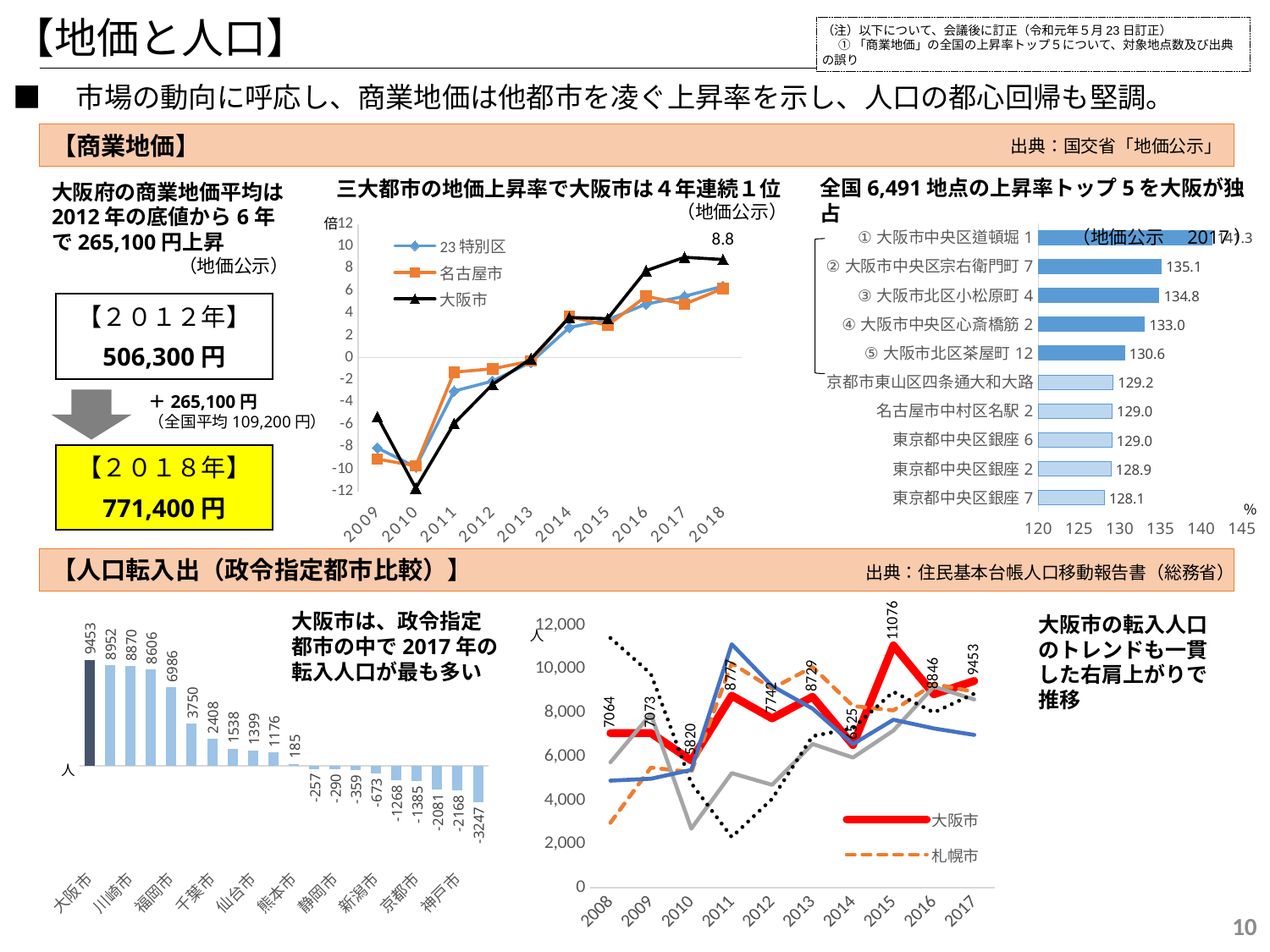
In the chart titled 三大都市の地価上昇率で大阪市は４年連続１位, is the value for 大阪市 in 2018 greater or less than 6? greater In the chart titled 三大都市の地価上昇率で大阪市は４年連続１位, how many series does the legend list? 3 In the chart titled 三大都市の地価上昇率で大阪市は４年連続１位, what kind of chart is it? line chart In the chart titled 全国6,491地点の上昇率トップ5を大阪が独占, which is larger, 大阪市中央区心斎橋筋2 or 大阪市北区茶屋町12? 大阪市中央区心斎橋筋2 In the chart titled 三大都市の地価上昇率で大阪市は４年連続１位, is the value for 大阪市 in 2010 greater or less than -10? less In the chart titled 全国6,491地点の上昇率トップ5を大阪が独占, how many locations are shown? 10 In the bottom-left bar chart under 人口転入出, which city has the highest value? 大阪市 In the chart titled 三大都市の地価上昇率で大阪市は４年連続１位, do the values for 大阪市 generally rise or fall from 2010 to 2017? rise In the chart titled 全国6,491地点の上昇率トップ5を大阪が独占, which location has the lowest value? 東京都中央区銀座7 In the chart titled 全国6,491地点の上昇率トップ5を大阪が独占, what is the value for 大阪市中央区宗右衛門町7? 135.1 In the chart titled 全国6,491地点の上昇率トップ5を大阪が独占, what is the difference between 大阪市中央区宗右衛門町7 and 大阪市北区小松原町4? 0.3 In the bottom-right line chart under 人口転入出, what is the value for 大阪市 in 2015? 11076